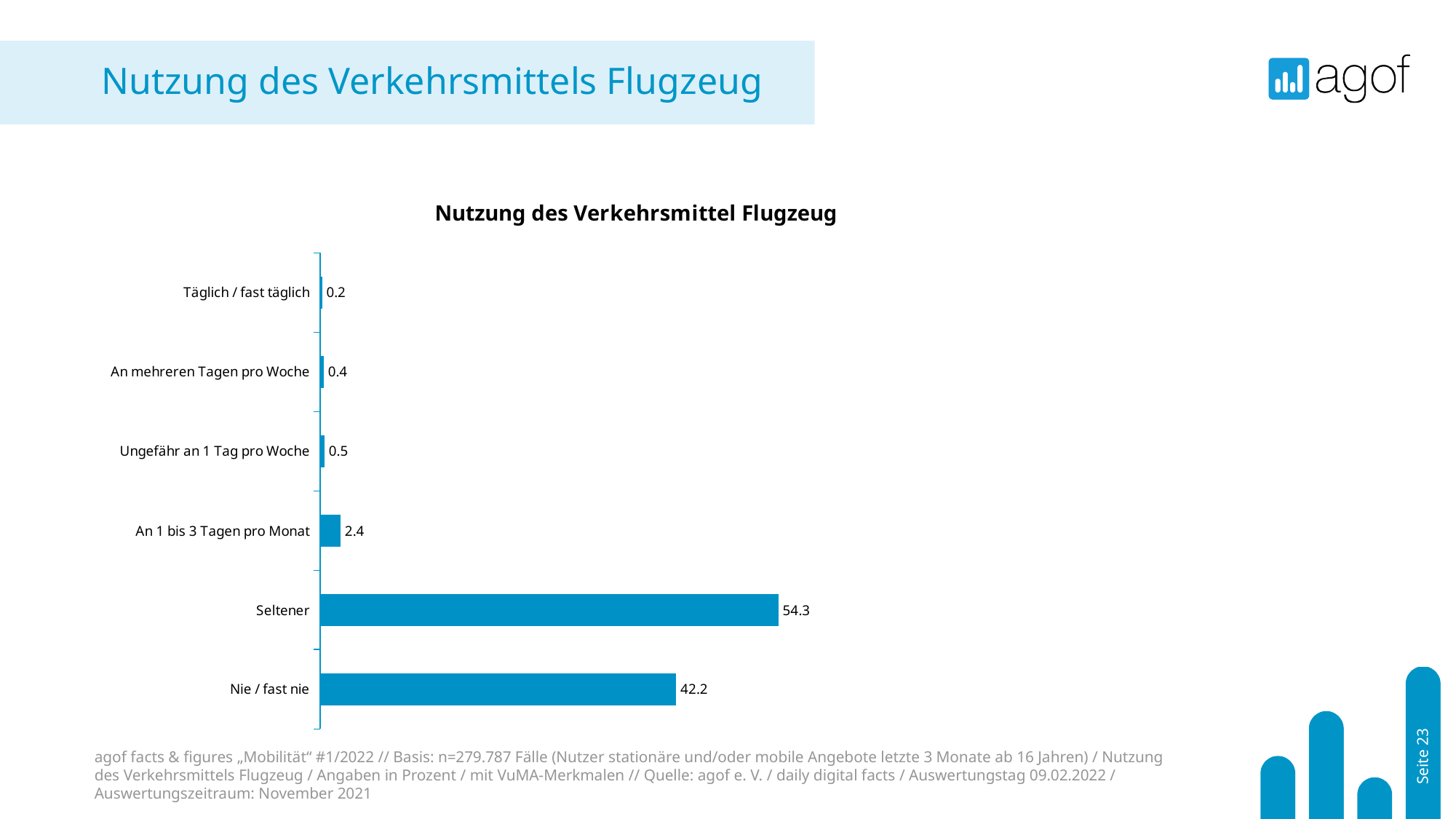
What is the title of the chart? Nutzung des Verkehrsmittel Flugzeug What is the value for "Seltener"? 54.3 Which category has the lowest value? Täglich / fast täglich What is the value for "Ungefähr an 1 Tag pro Woche"? 0.5 Which category has the highest value? Seltener What is the value for "Täglich / fast täglich"? 0.2 What kind of chart is shown on the slide? Bar chart Which is larger, the value for "An mehreren Tagen pro Woche" or the value for "An 1 bis 3 Tagen pro Monat"? An 1 bis 3 Tagen pro Monat What is the difference between the values for "Seltener" and "Nie / fast nie"? 12.1 What is the value for "An 1 bis 3 Tagen pro Monat"? 2.4 How many categories are shown in the chart? 6 What is the value for "Nie / fast nie"? 42.2